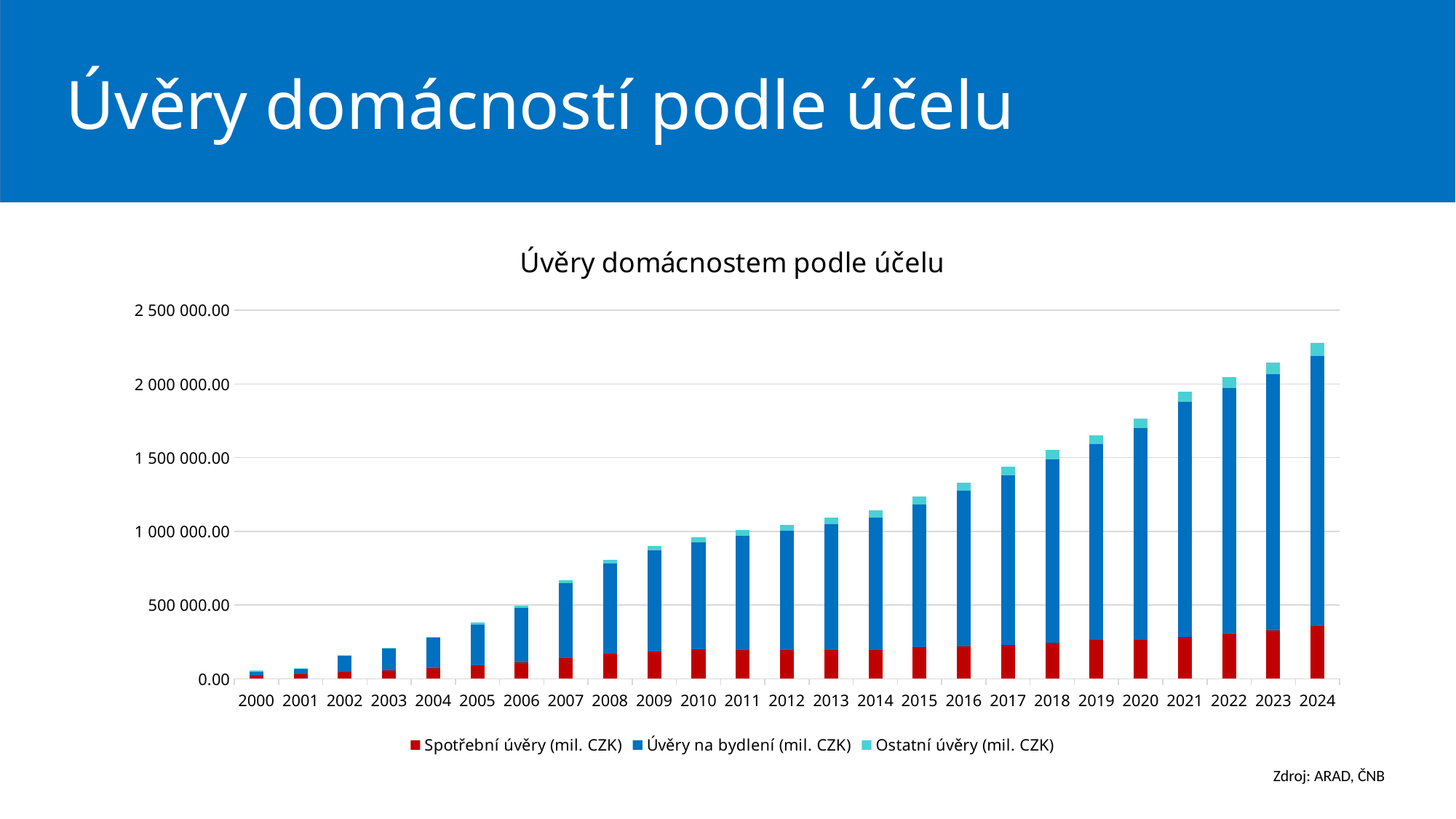
Which series is shown in red? Spotřební úvěry (mil. CZK) What kind of chart is shown on the slide? Stacked bar chart Which year has the highest total value? 2024 Is the total value for 2008 greater or less than 1 000 000.00? less What is the title of the chart? Úvěry domácnostem podle účelu Do the total values rise or fall from 2000 to 2024? Rise How many series does the legend list? 3 Which year has the lowest total value? 2000 Is the total value for 2024 greater or less than 2 000 000.00? greater Is the total value for 2019 greater or less than 1 500 000.00? greater How many years are shown on the x axis? 25